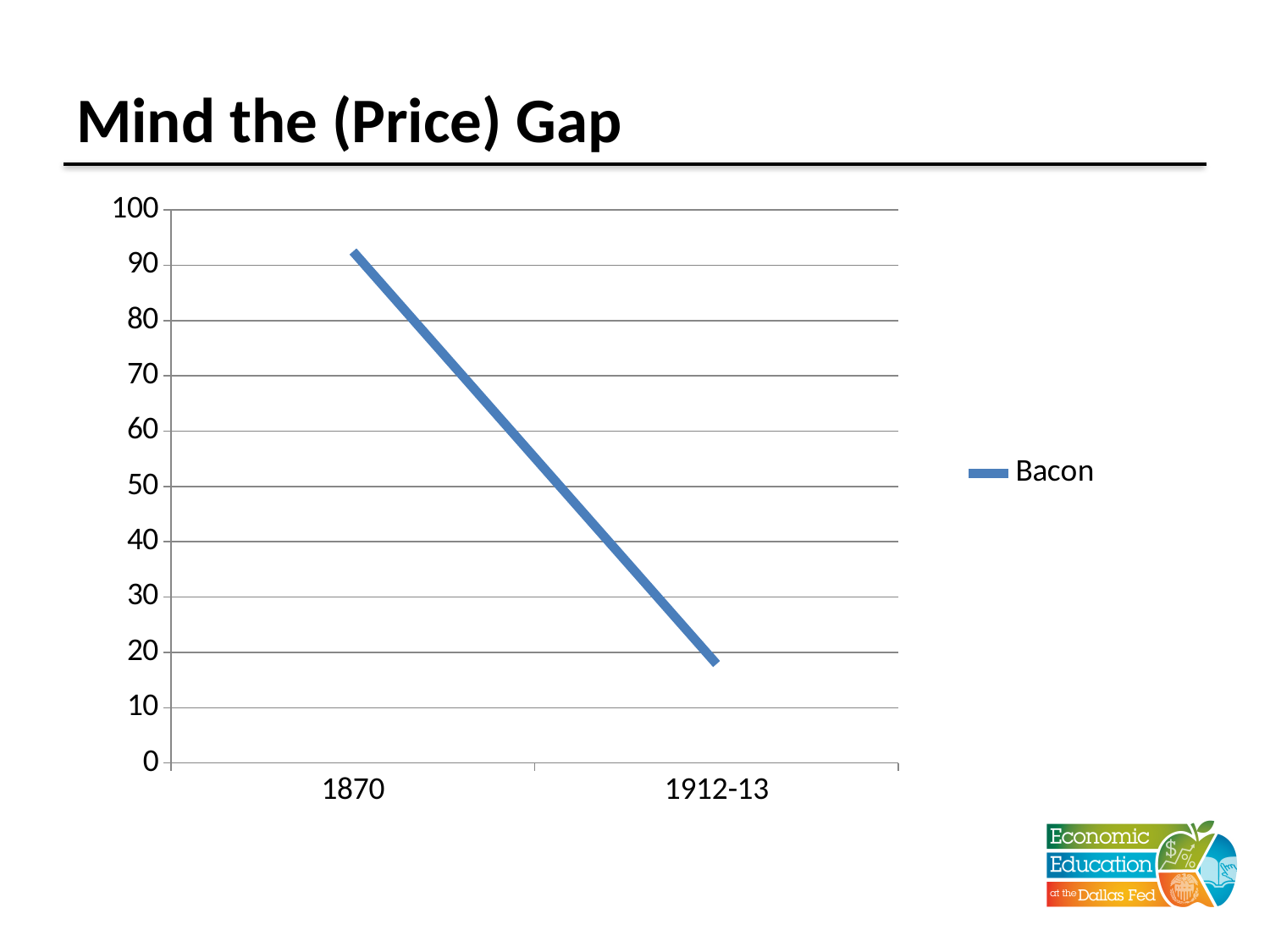
Which is larger, the Bacon value for 1870 or for 1912-13? 1870 How many points are plotted on the Bacon line? 2 Is the Bacon value for 1912-13 greater or less than 30? less What is the name of the series shown in the legend? Bacon Is the Bacon value for 1912-13 greater or less than 10? greater Which category has the highest value for Bacon? 1870 What kind of chart is shown on the slide? line chart What is the title of the slide containing the chart? Mind the (Price) Gap Does the Bacon line rise or fall from 1870 to 1912-13? fall Which category has the lowest value for Bacon? 1912-13 Is the Bacon value for 1870 greater or less than 80? greater How many series does the legend list? 1